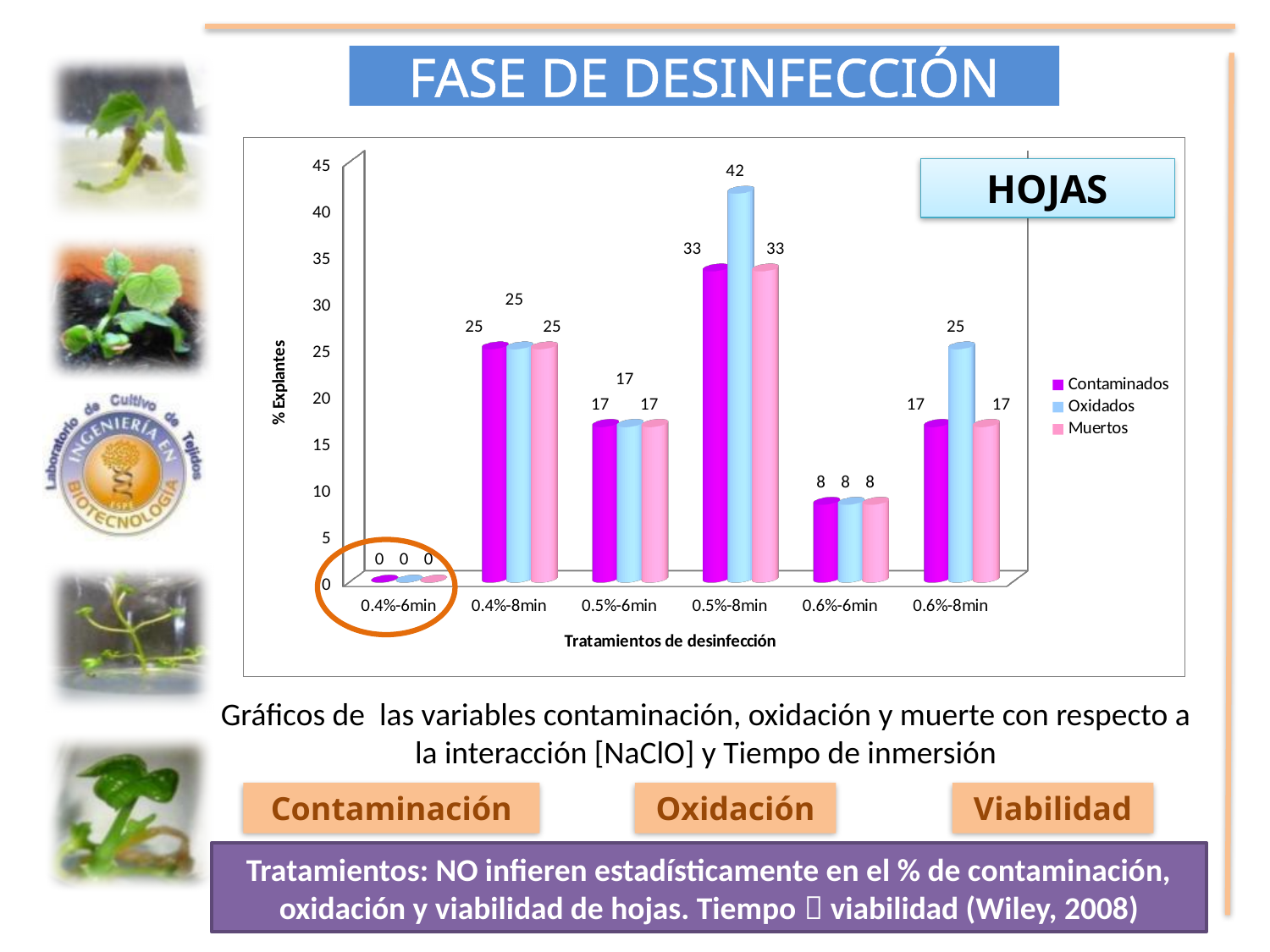
Which treatment has the lowest Contaminados value? 0.4%-6min What is the value for Oxidados at 0.5%-8min? 42 What is the label of the y axis? % Explantes What is the value for Oxidados at 0.6%-8min? 25 What kind of chart is shown? Bar chart How many treatment categories are shown on the x axis? 6 How many series does the legend list? 3 What is the value for Muertos at 0.6%-6min? 8 Which is larger: the Oxidados value at 0.6%-8min or the Muertos value at 0.6%-8min? Oxidados Which treatment has the highest Oxidados value? 0.5%-8min What is the difference between the Oxidados and Contaminados values at 0.5%-8min? 9 What is the value for Contaminados at 0.4%-8min? 25